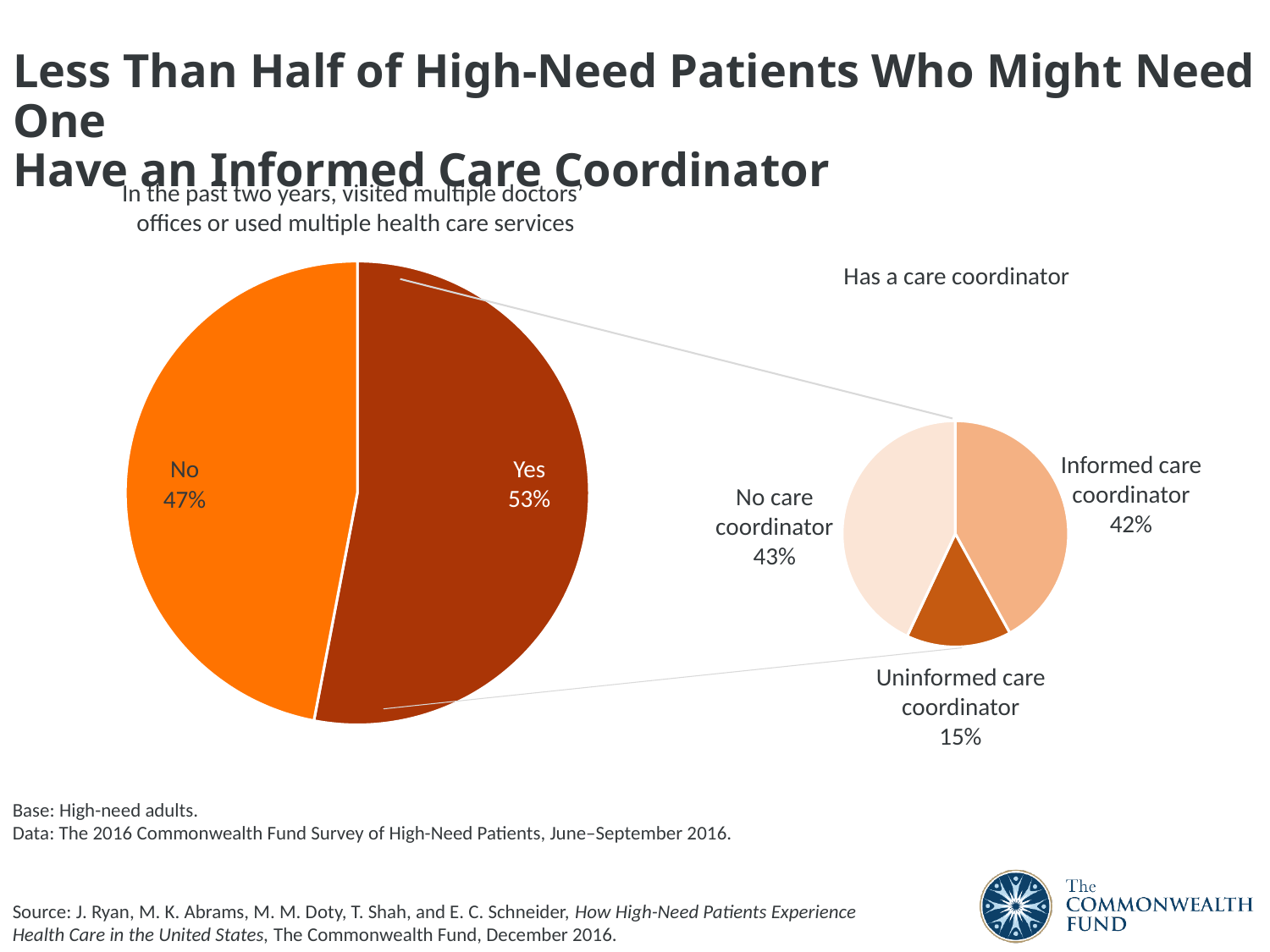
In the left pie chart, what percentage of high-need adults answered Yes to having visited multiple doctors' offices or used multiple health care services in the past two years? 53% How many slices does the right pie chart have? 3 In the right pie chart, what is the difference in percentage points between no care coordinator and uninformed care coordinator? 28 percentage points In the right pie chart, what share has no care coordinator? 43% What type of chart is used on this slide? Pie chart In the right pie chart, which is larger: informed care coordinator or uninformed care coordinator? Informed care coordinator In the right pie chart, which category has the smallest slice? Uninformed care coordinator In the right pie chart, which category has the largest slice? No care coordinator In the left pie chart, what percentage answered No? 47% In the left pie chart, what is the difference in percentage points between Yes and No? 6 percentage points In the right pie chart, what share has an uninformed care coordinator? 15% In the right pie chart, what share has an informed care coordinator? 42%